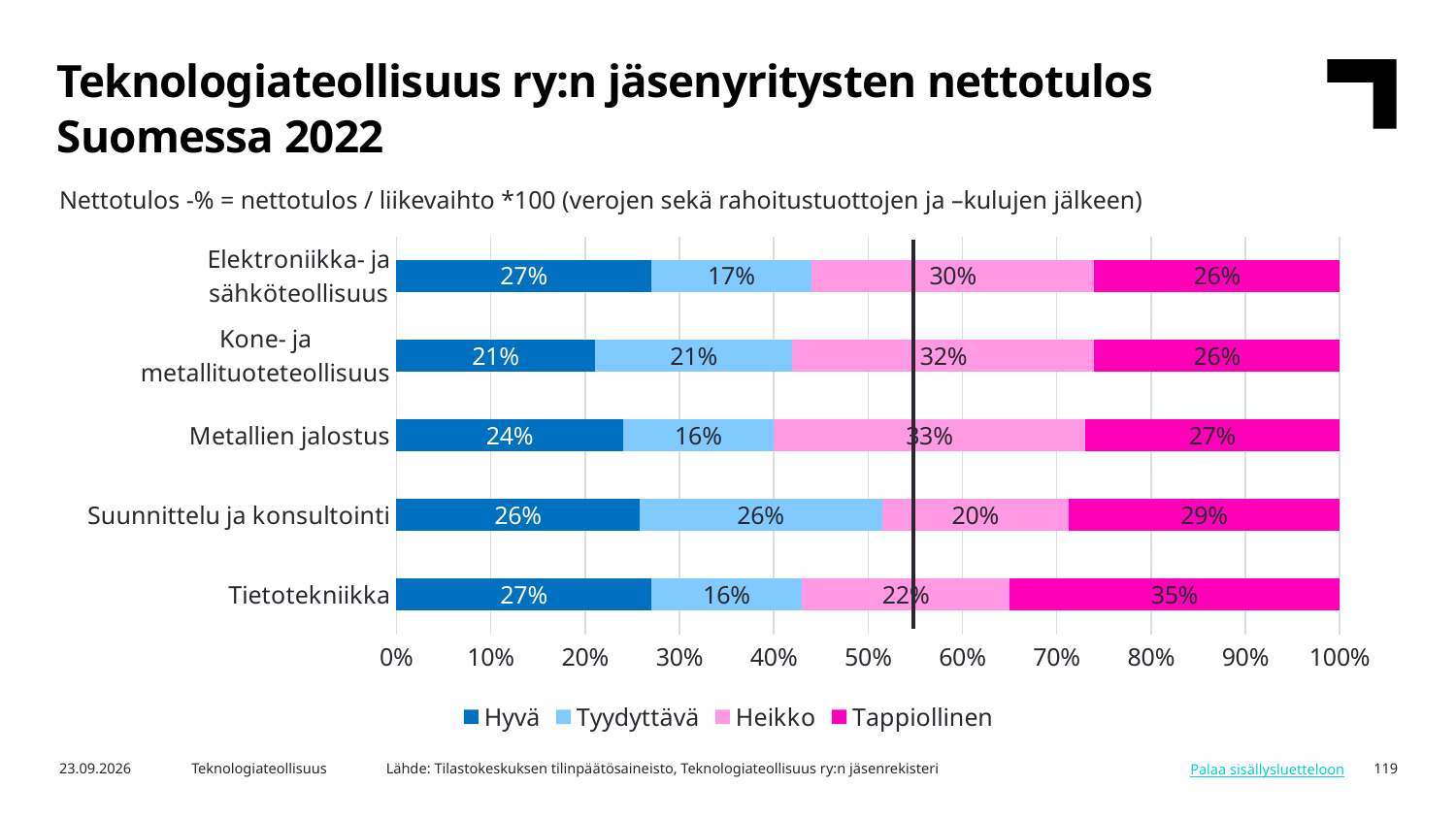
Which legend entry is shown in dark blue? Hyvä How many series does the legend list? 4 How many industry categories are shown in the chart? 5 What is the Tyydyttävä share for Suunnittelu ja konsultointi? 26% Which category has the lowest Hyvä share? Kone- ja metallituoteteollisuus What is the Tappiollinen share for Tietotekniikka? 35% What is the Heikko share for Kone- ja metallituoteteollisuus? 32% What kind of chart is shown on the slide? Stacked bar chart Which category has the highest Tappiollinen share? Tietotekniikka What is the difference between the Heikko share of Metallien jalostus and that of Suunnittelu ja konsultointi? 13 percentage points Which is larger: the Tyydyttävä share for Elektroniikka- ja sähköteollisuus or for Kone- ja metallituoteteollisuus? Kone- ja metallituoteteollisuus What is the Hyvä share for Metallien jalostus? 24%